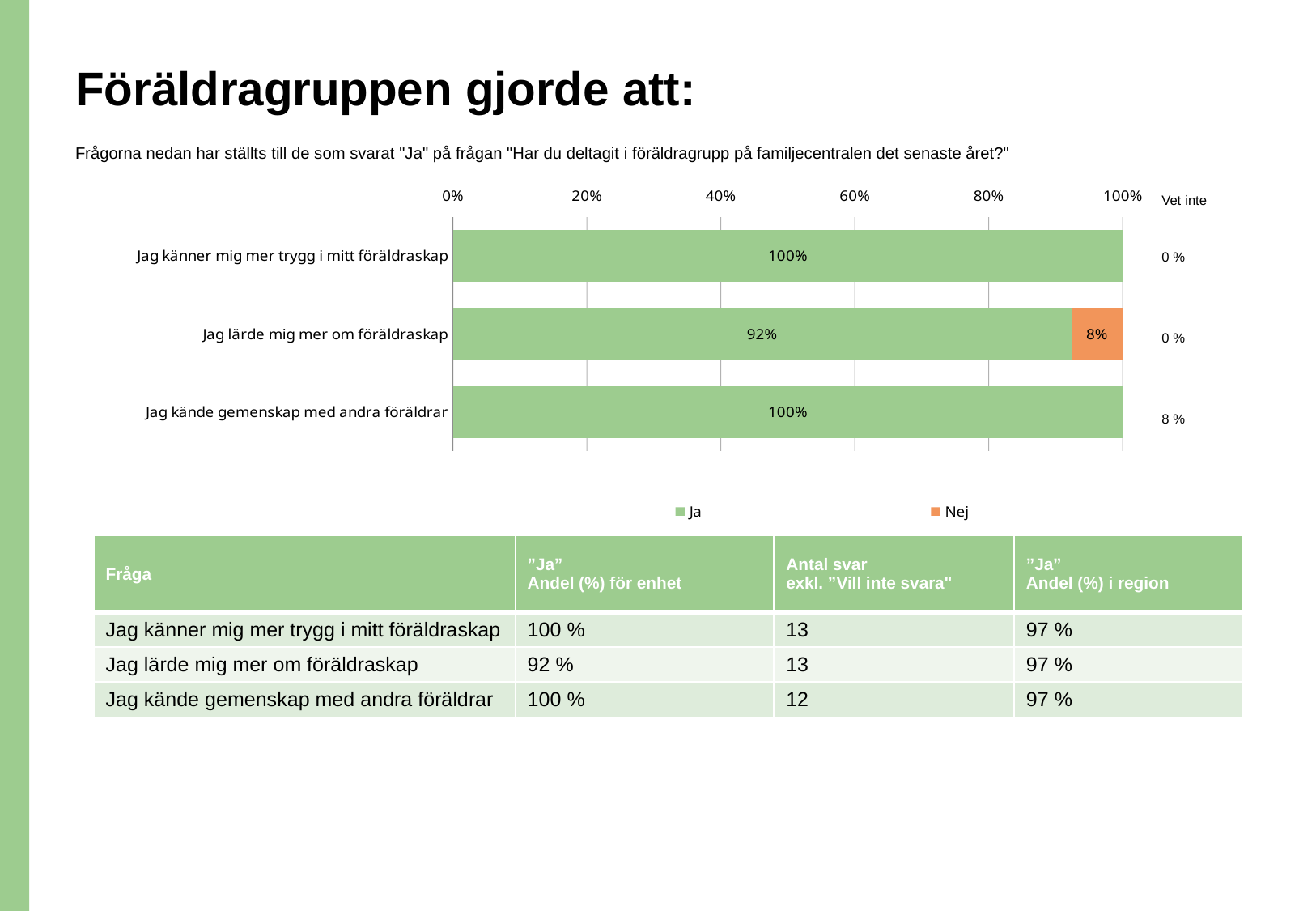
How many series does the legend list? 2 How many categories are shown in the chart? 3 What is the total of the stacked bar for "Jag lärde mig mer om föräldraskap"? 100% What is the "Nej" value for "Jag lärde mig mer om föräldraskap"? 8% What kind of chart is shown on the slide? bar chart Which category has the lowest "Ja" value? Jag lärde mig mer om föräldraskap What is the "Ja" value for "Jag kände gemenskap med andra föräldrar"? 100% Is the "Ja" value for "Jag lärde mig mer om föräldraskap" greater or less than 80%? greater Which colour represents the "Nej" series in the chart? orange What is the "Ja" value for "Jag känner mig mer trygg i mitt föräldraskap"? 100% What is the difference between the "Ja" and "Nej" values for "Jag lärde mig mer om föräldraskap"? 84% What is the "Ja" value for "Jag lärde mig mer om föräldraskap"? 92%